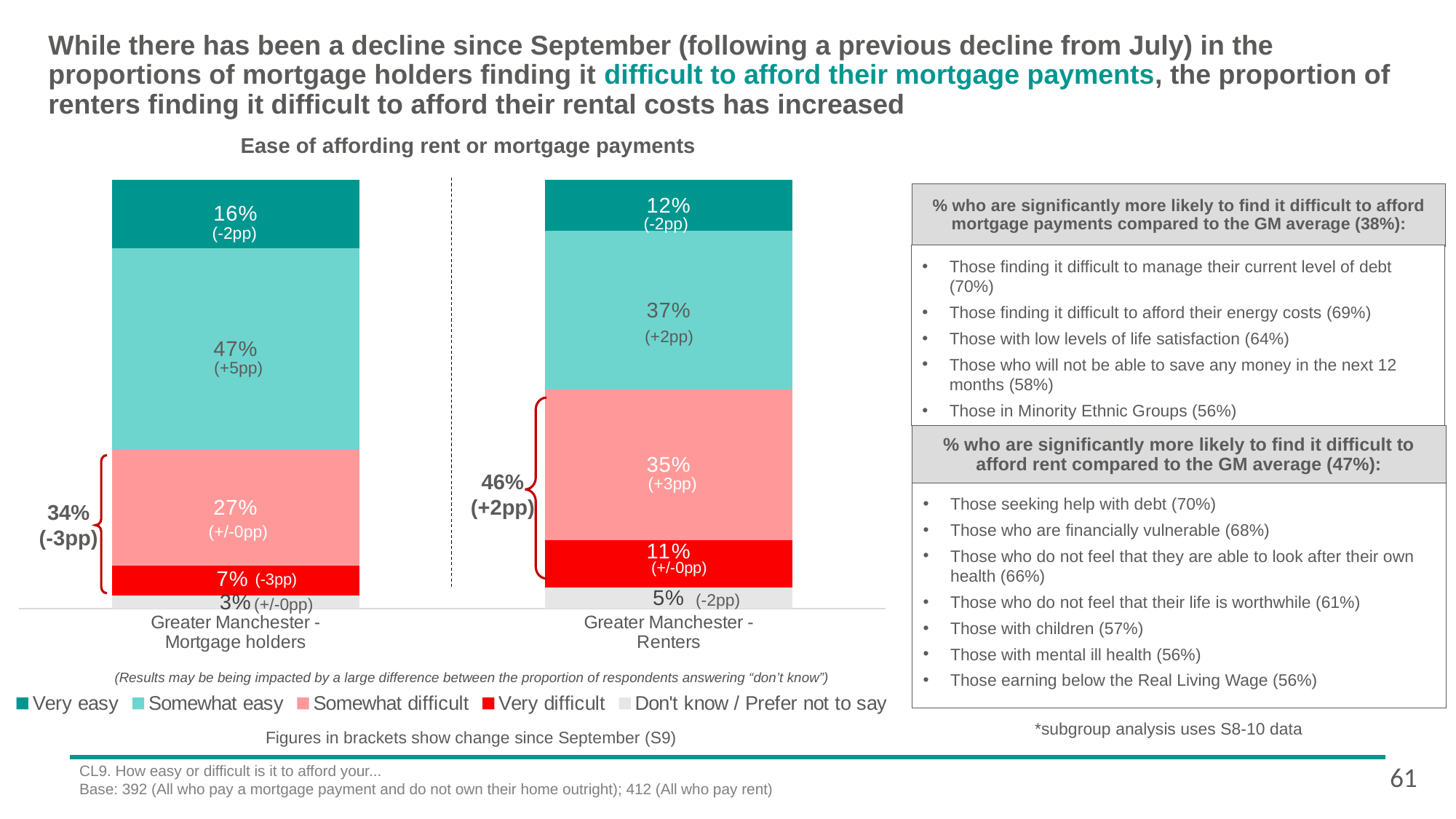
What is the combined 'difficult' (somewhat + very difficult) percentage shown for Greater Manchester renters? 46% Which segment is the smallest in the Greater Manchester - Renters bar? Don't know / Prefer not to say What percentage of Greater Manchester mortgage holders find it somewhat easy to afford their payments? 47% Which segment is the largest in the Greater Manchester - Mortgage holders bar? Somewhat easy What is the chart's title? Ease of affording rent or mortgage payments How many series does the legend list? 5 Which group has a higher 'Very difficult' percentage, mortgage holders or renters? Renters What percentage of Greater Manchester renters find it very difficult to afford their rent? 11% What percentage of Greater Manchester renters answered 'Very easy'? 12% What kind of chart is shown on the slide? Stacked bar chart How many categories (bars) are plotted on the chart? 2 What is the difference between the 'Somewhat difficult' percentages for renters and mortgage holders? 8 percentage points